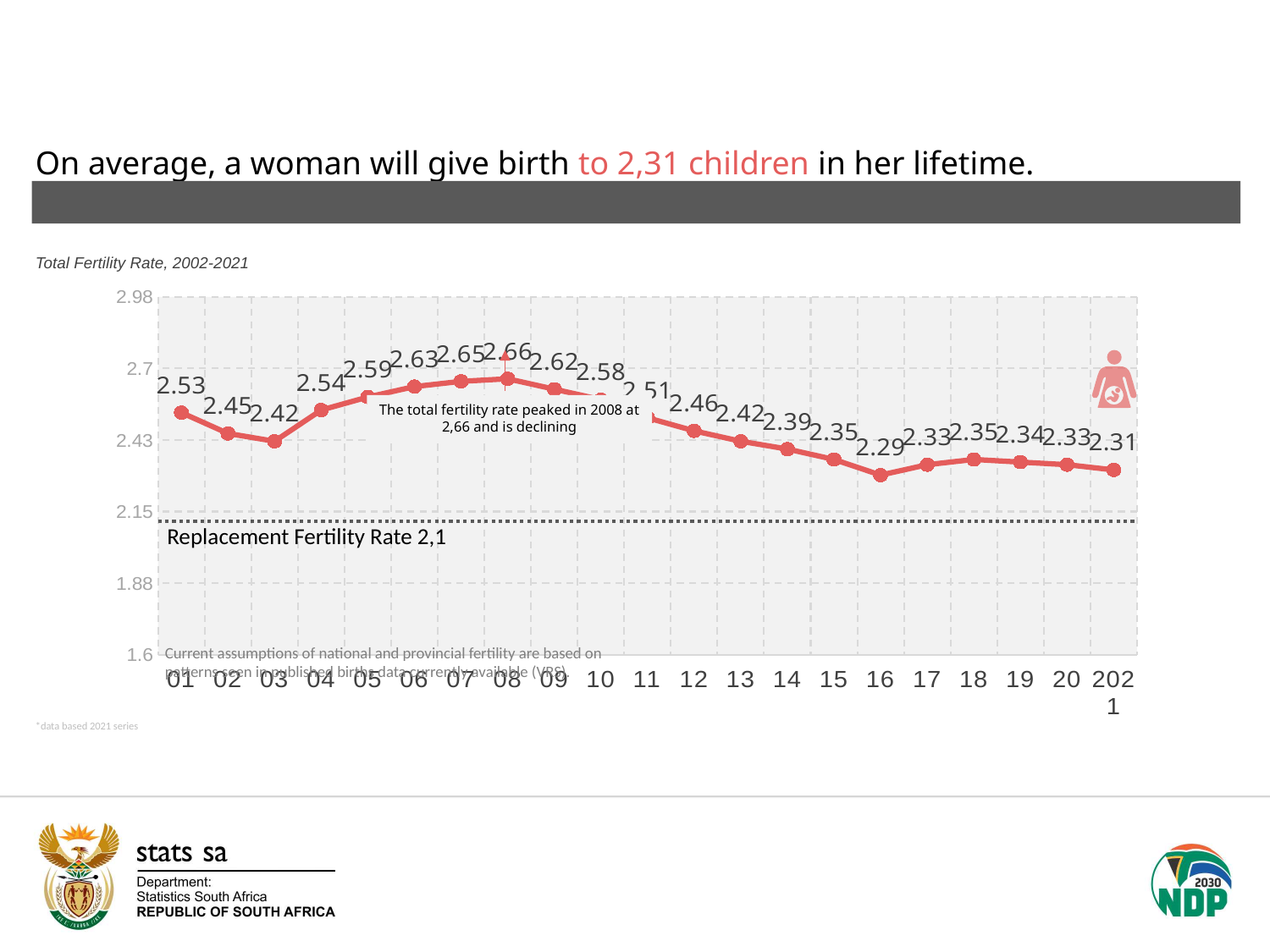
What is the total fertility rate value labelled at x-axis point 16? 2.29 What is the title of the chart? Total Fertility Rate, 2002-2021 What is the total fertility rate value labelled at x-axis point 08? 2.66 What kind of chart is shown on the slide? line chart What is the total fertility rate value labelled at x-axis point 2021? 2.31 At which x-axis point is the total fertility rate lowest? 16 What is the difference between the value at 08 and the value at 2021? 0.35 What replacement fertility rate is marked by the dotted line on the chart? 2,1 Which is larger, the value at 01 or the value at 20? 01 At which x-axis point is the total fertility rate highest? 08 Do the values rise or fall from x-axis point 08 to x-axis point 16? fall How many data points are plotted on the line? 21